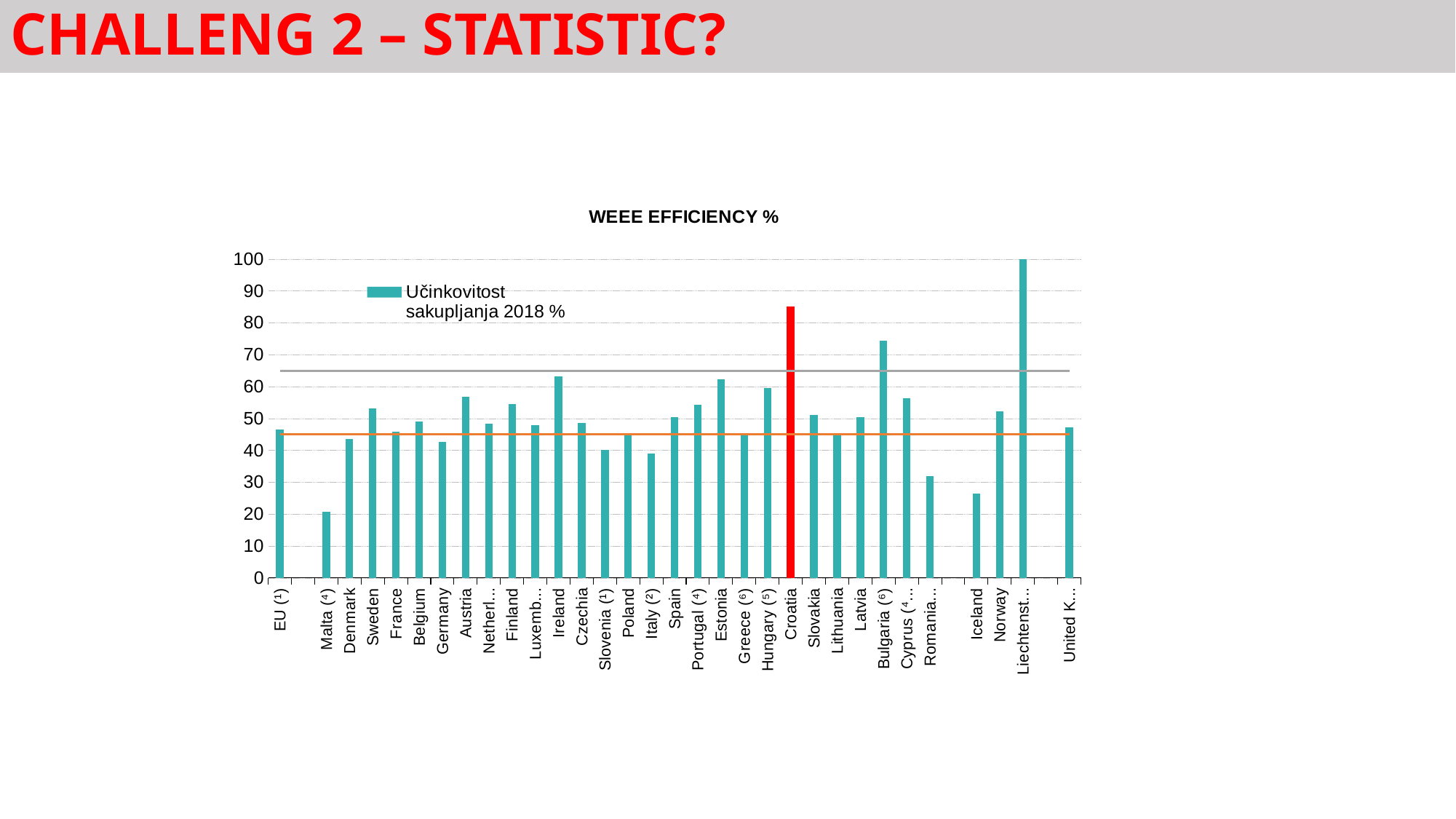
Is the value for Malta greater or less than 30? less Which category has the lowest value? Malta What is the title of the chart? WEEE EFFICIENCY % Which is larger, the value for Sweden or the value for Denmark? Sweden Is the value for Bulgaria greater or less than 70? greater Which category has the highest value? Liechtenstein What kind of chart is shown on the slide? bar chart Which country's bar is highlighted in red? Croatia How many series does the legend list? 1 Is the value for Croatia greater or less than 80? greater